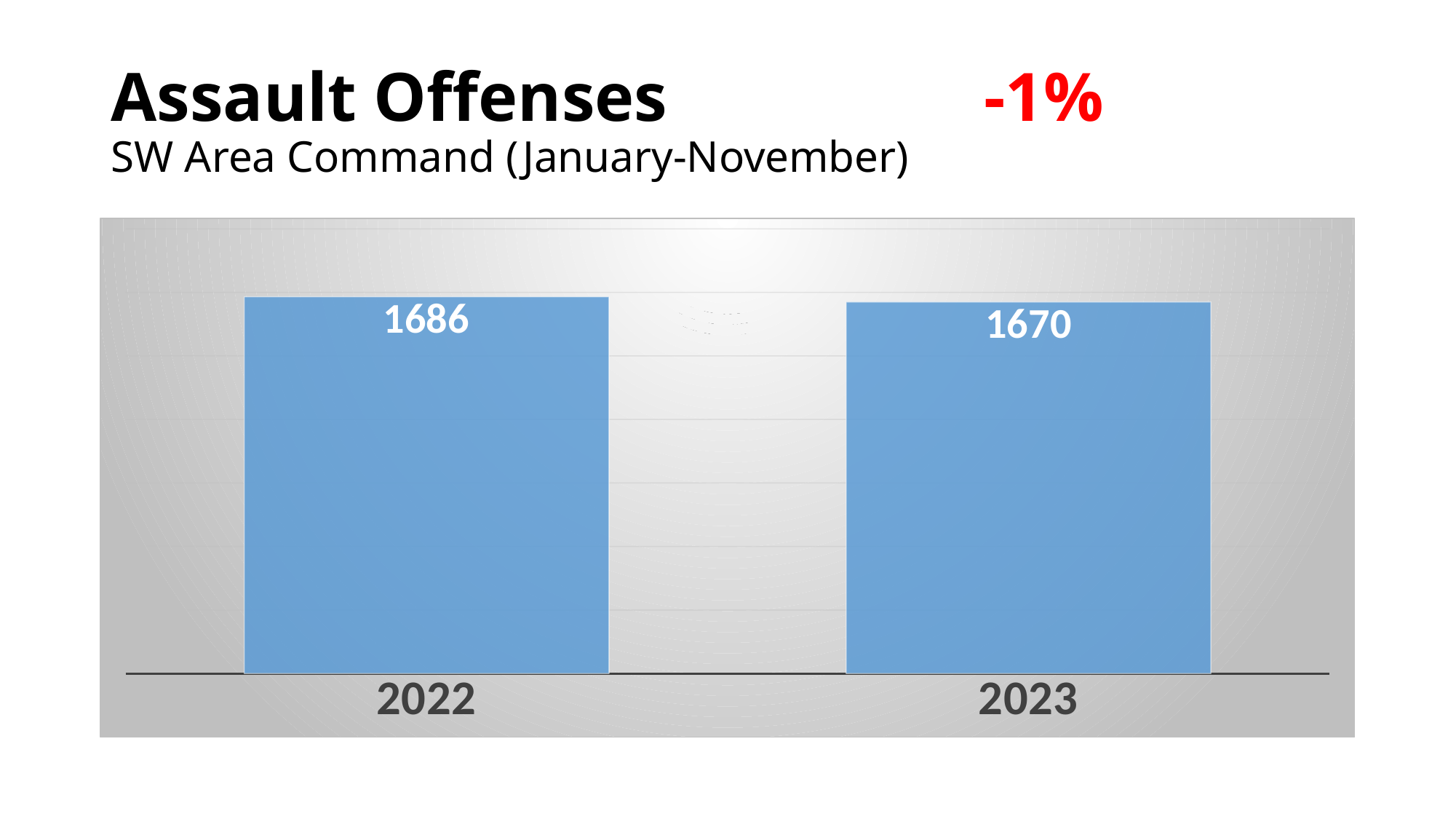
What is the difference between the 2022 and 2023 values? 16 What is the title of the chart? Assault Offenses How many categories are shown on the x axis? 2 Which year has the lower value? 2023 What is the value for 2023? 1670 What kind of chart is shown on the slide? bar chart Is the value for 2022 larger or smaller than the value for 2023? larger Which year has the higher value? 2022 What is the value for 2022? 1686 Do the values rise or fall from 2022 to 2023? fall What percentage change is shown in red on the slide? -1%